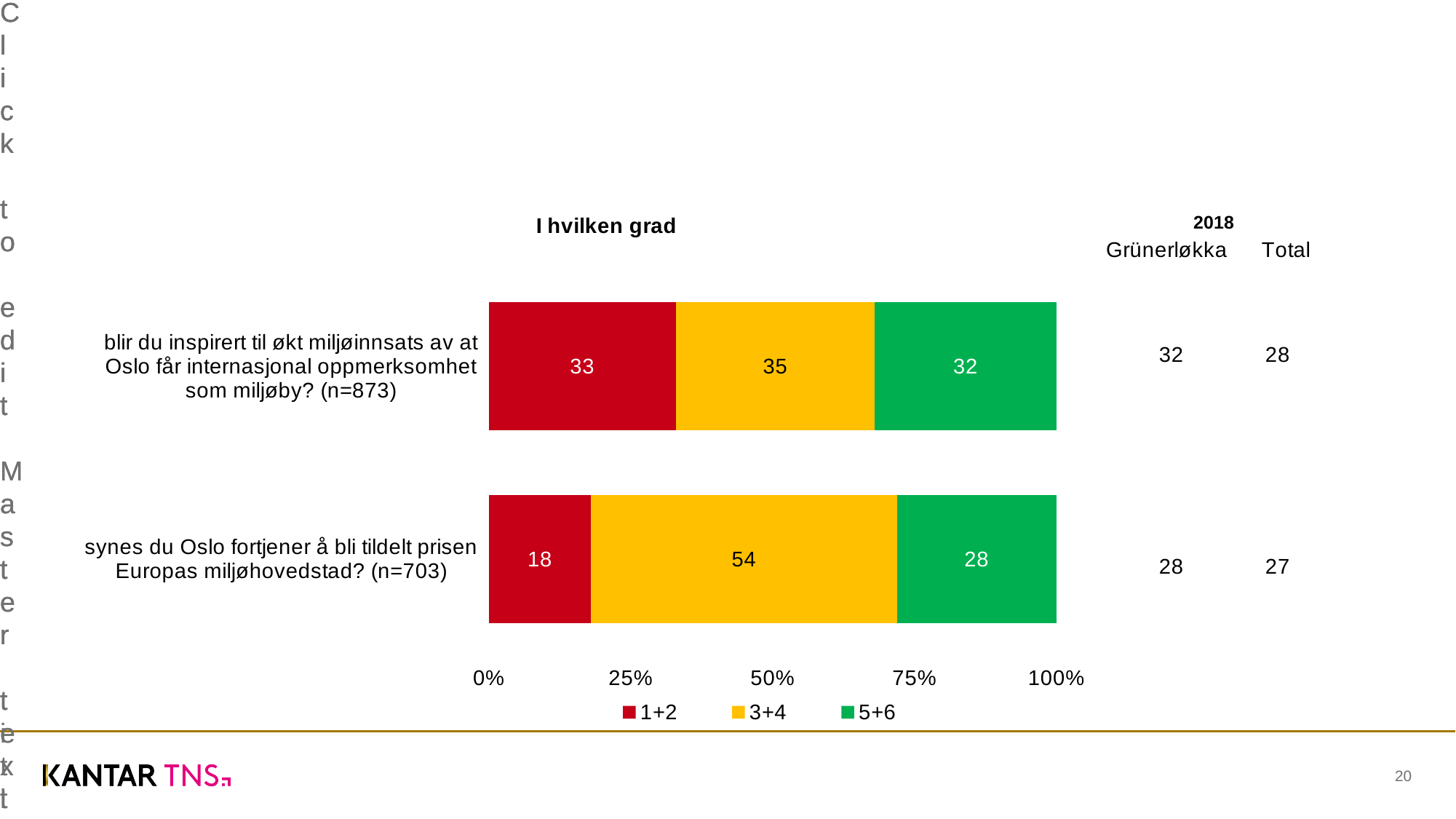
What is the value of the 3+4 segment for "synes du Oslo fortjener å bli tildelt prisen Europas miljøhovedstad?"? 54 Which category has the larger 1+2 segment? blir du inspirert til økt miljøinnsats av at Oslo får internasjonal oppmerksomhet som miljøby? What is the value of the 1+2 segment for "blir du inspirert til økt miljøinnsats av at Oslo får internasjonal oppmerksomhet som miljøby?"? 33 How many categories (questions) are plotted in the chart? 2 What is the 2018 Grünerløkka value shown next to "blir du inspirert til økt miljøinnsats av at Oslo får internasjonal oppmerksomhet som miljøby?"? 32 What is the difference between the 3+4 values of the two categories? 19 What is the value of the 5+6 segment for "synes du Oslo fortjener å bli tildelt prisen Europas miljøhovedstad?"? 28 What kind of chart is shown on the slide? Stacked bar chart What is the title of the chart? I hvilken grad How many series does the legend list? 3 What is the total of the stacked bar for "blir du inspirert til økt miljøinnsats av at Oslo får internasjonal oppmerksomhet som miljøby?"? 100 Which segment is the largest in the bar for "synes du Oslo fortjener å bli tildelt prisen Europas miljøhovedstad?"? 3+4